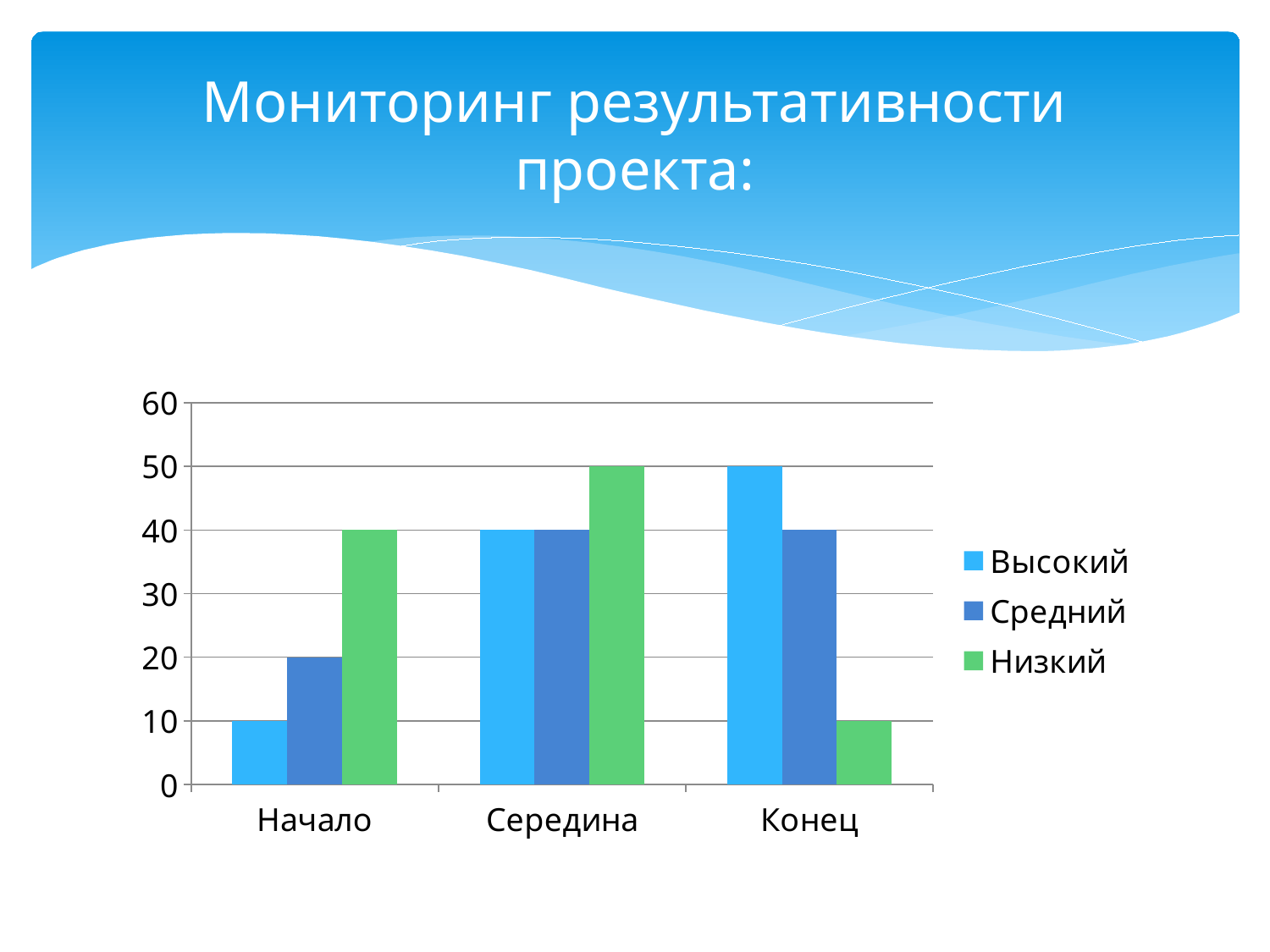
Does the Высокий series rise or fall from Начало to Конец? rise At which category is the Высокий series highest? Конец Which series is shown in green in the legend? Низкий What is the value for Средний at Конец? 40 What kind of chart is shown on the slide? bar chart What is the value for Высокий at Начало? 10 How many series does the legend list? 3 How many categories are shown on the x axis? 3 What is the value for Низкий at Середина? 50 What is the difference between Низкий at Начало and Низкий at Конец? 30 At which category is the Низкий series lowest? Конец Which is larger: Высокий at Начало or Низкий at Начало? Низкий at Начало